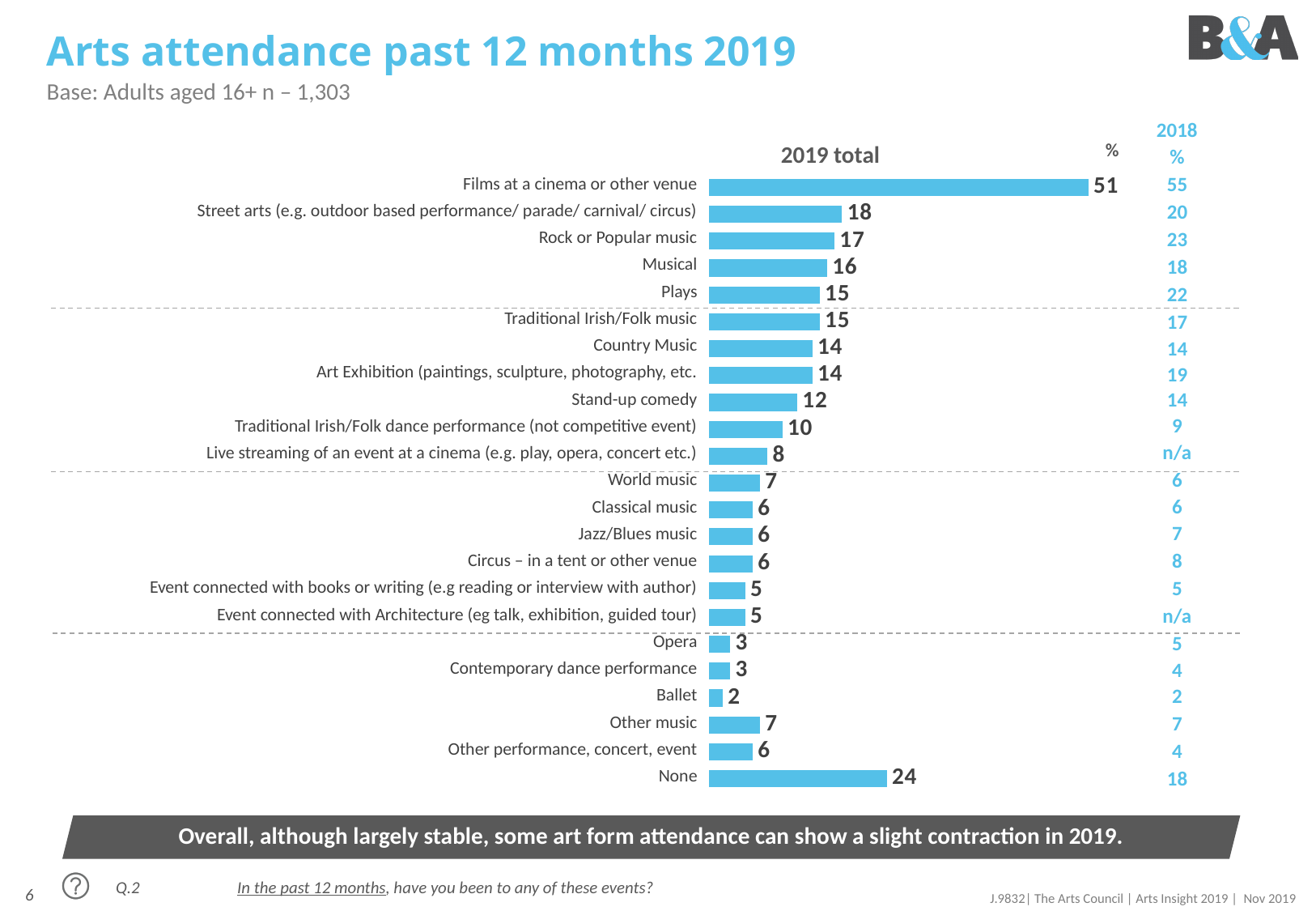
Which category has the lowest 2019 total value? Ballet How many categories are plotted in the chart? 23 Which category has the highest 2019 total value? Films at a cinema or other venue What is the difference between the 2019 total values for Films at a cinema or other venue and None? 27 What is the 2019 total value for Films at a cinema or other venue? 51 What is the 2019 total value for Live streaming of an event at a cinema? 8 What is the title shown above the bars in the chart? 2019 total What is the 2019 total value for Stand-up comedy? 12 What kind of chart is shown on the slide? Bar chart What is the 2019 total value for None? 24 What is the difference between the 2019 total values for Street arts and Rock or Popular music? 1 Which has a larger 2019 total value, Stand-up comedy or Live streaming of an event at a cinema? Stand-up comedy